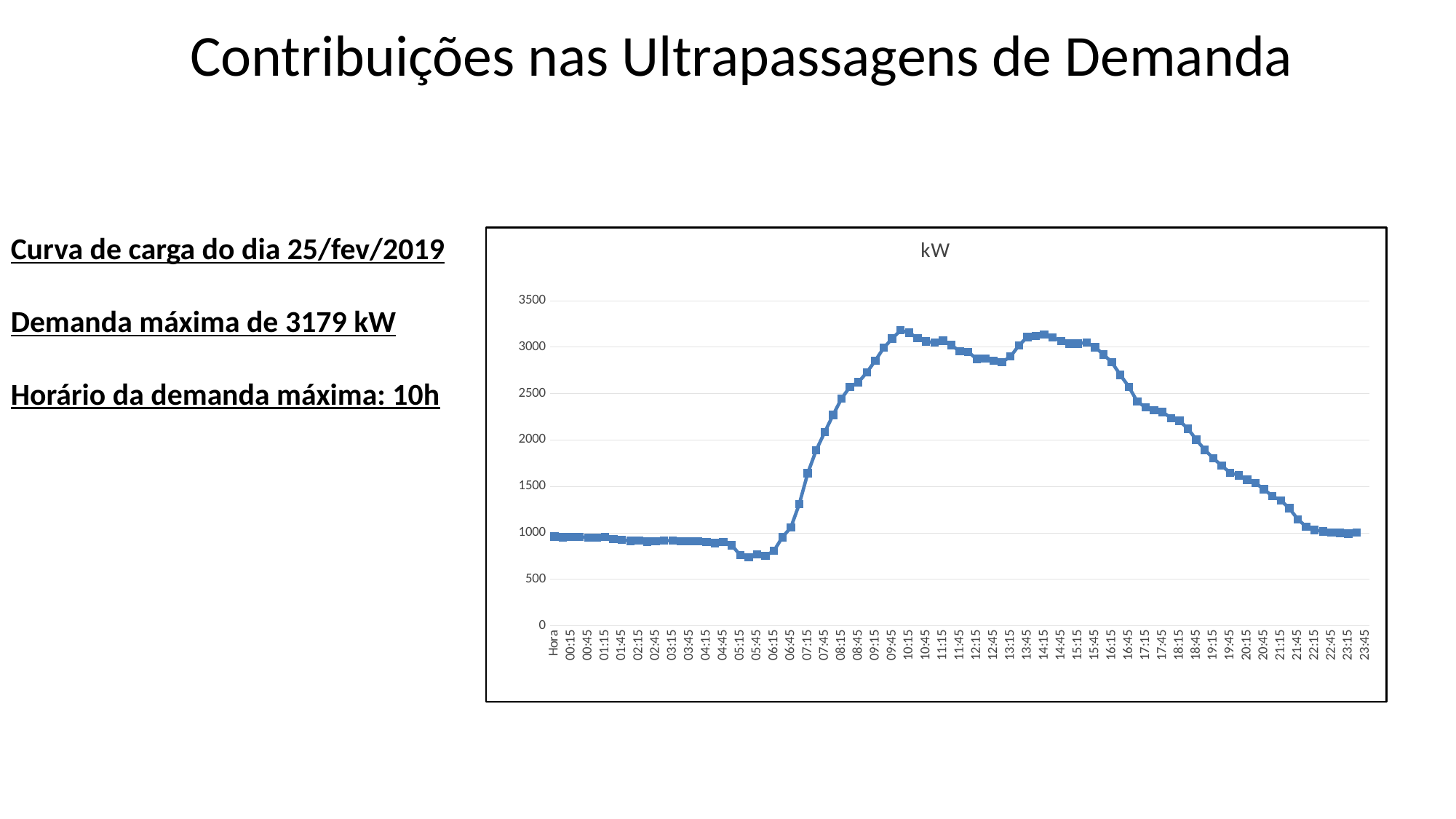
Do the values rise or fall between 06:15 and 09:45? rise Do the values rise or fall between 16:15 and 21:45? fall What kind of chart is shown on the slide? line chart Around what time of day does the chart reach its lowest value? 05:30 Is the value at 12:45 greater or less than 3000? less What is the title of the chart? kW Is the value at 18:15 greater or less than 2000? greater Is the value at 05:30 greater or less than 1000? less Which is larger, the value at 10:15 or the value at 12:45? 10:15 Around what time of day does the chart reach its highest value? 10:00